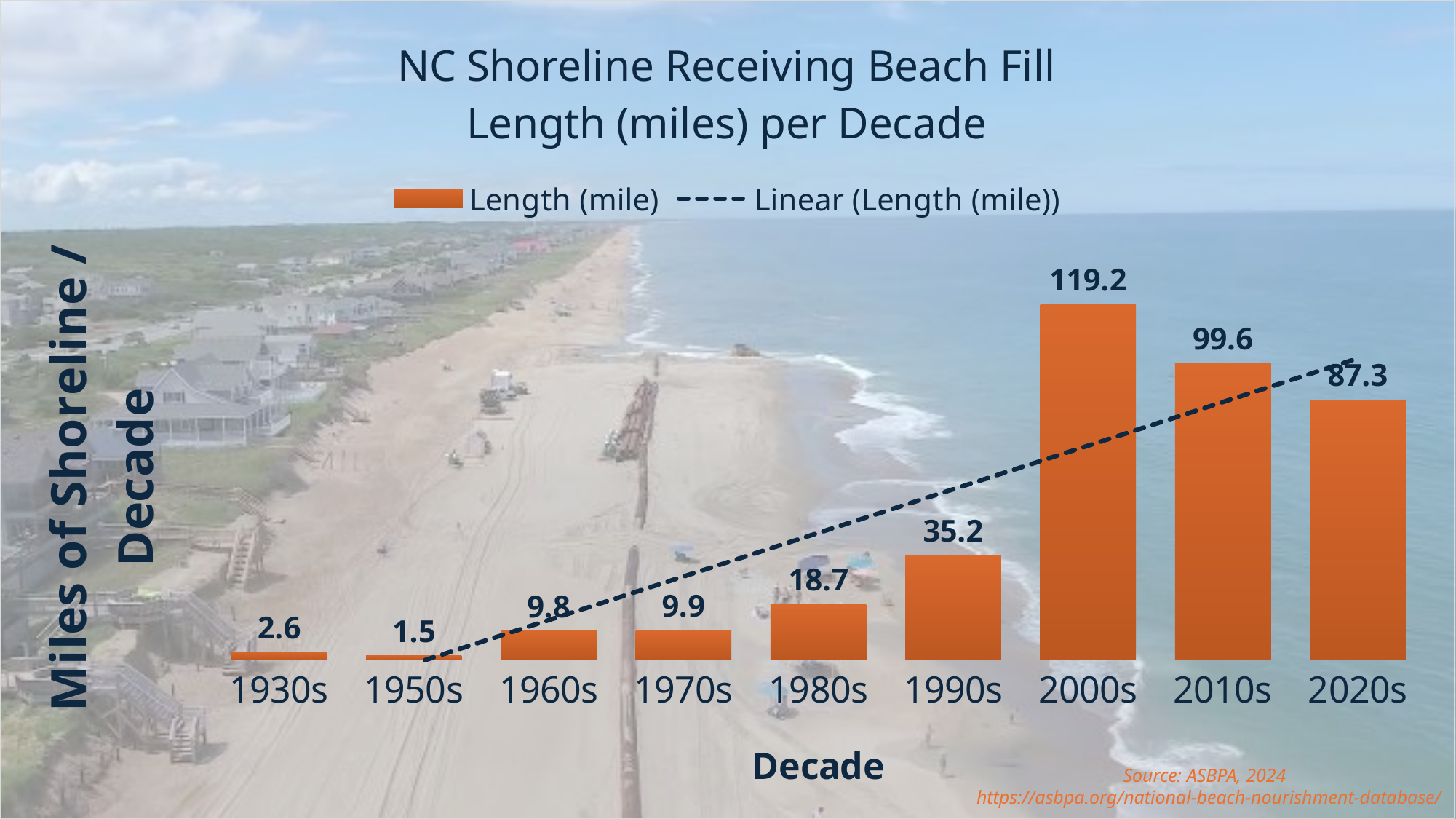
Which decade has the lowest length of shoreline receiving beach fill? 1950s What is the difference between the values for the 2000s and the 2010s? 19.6 What is the length of NC shoreline receiving beach fill in the 2000s? 119.2 What is the value shown for the 2020s? 87.3 What is the value shown for the 1980s? 18.7 Which decade has a larger value, the 1990s or the 2020s? 2020s What kind of chart is shown on the slide? Bar chart How many decades are shown on the x axis? 9 What is the label of the x axis? Decade What is the difference between the values for the 1990s and the 1980s? 16.5 Which decade has the highest length of shoreline receiving beach fill? 2000s How many entries does the legend list? 2